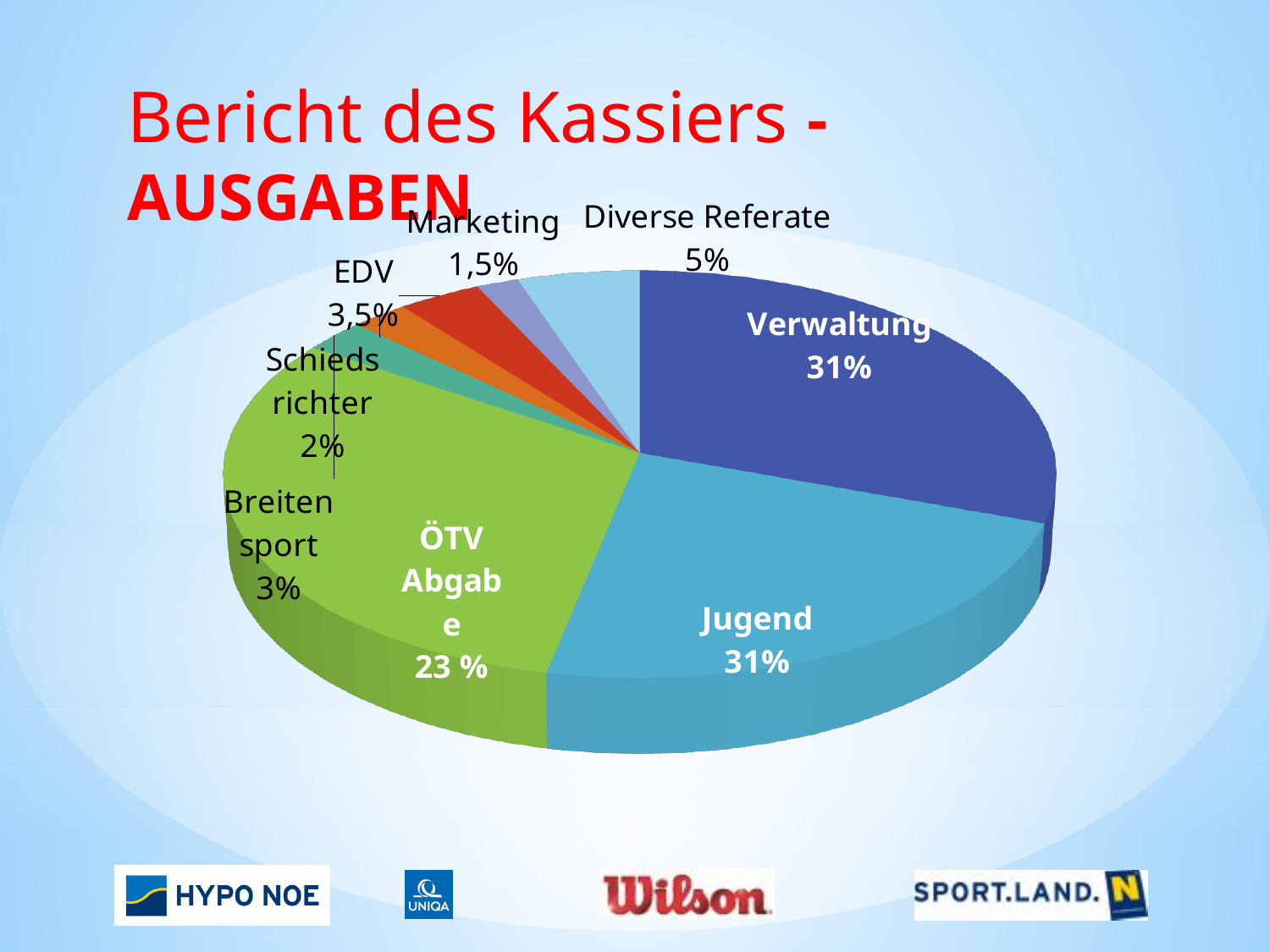
Which category has the smallest slice of the pie? Marketing What is the value shown for ÖTV Abgabe? 23 % What is the difference in percentage points between Verwaltung and ÖTV Abgabe? 8 What percentage is shown for Diverse Referate? 5% What percentage is shown for Schiedsrichter? 2% What share of expenses does Verwaltung account for? 31% Which is larger, the slice for Breitensport or the slice for Schiedsrichter? Breitensport What is the title of the slide containing the chart? Bericht des Kassiers - AUSGABEN What percentage is shown for EDV? 3,5% What share of expenses does Jugend account for? 31% How many slices does the pie chart have? 8 What type of chart is shown on the slide? pie chart